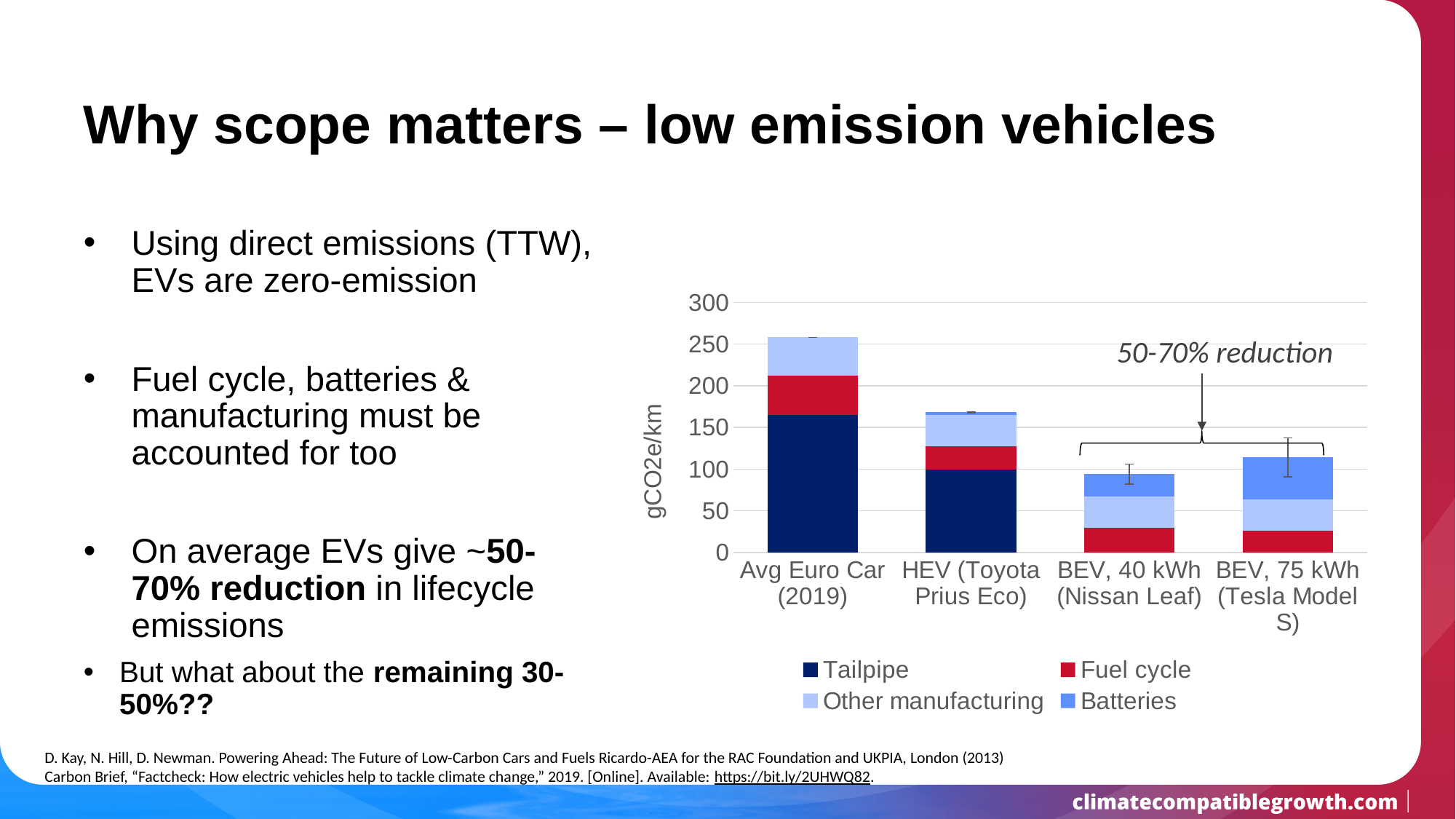
Is the total value for BEV, 40 kWh (Nissan Leaf) greater or less than 150? less Which vehicle category has the lowest total emissions in the chart? BEV, 40 kWh (Nissan Leaf) What is the label on the chart's y axis? gCO2e/km Which vehicle category has the highest total emissions in the chart? Avg Euro Car (2019) Which has higher total emissions: BEV, 75 kWh (Tesla Model S) or BEV, 40 kWh (Nissan Leaf)? BEV, 75 kWh (Tesla Model S) Is the total value for Avg Euro Car (2019) greater or less than 200? greater How many vehicle categories are shown on the x axis of the chart? 4 What kind of chart is shown on the slide? Stacked bar chart Is the total value for HEV (Toyota Prius Eco) greater or less than 150? greater How many series does the chart's legend list? 4 What annotation text is written above the two BEV bars in the chart? 50-70% reduction